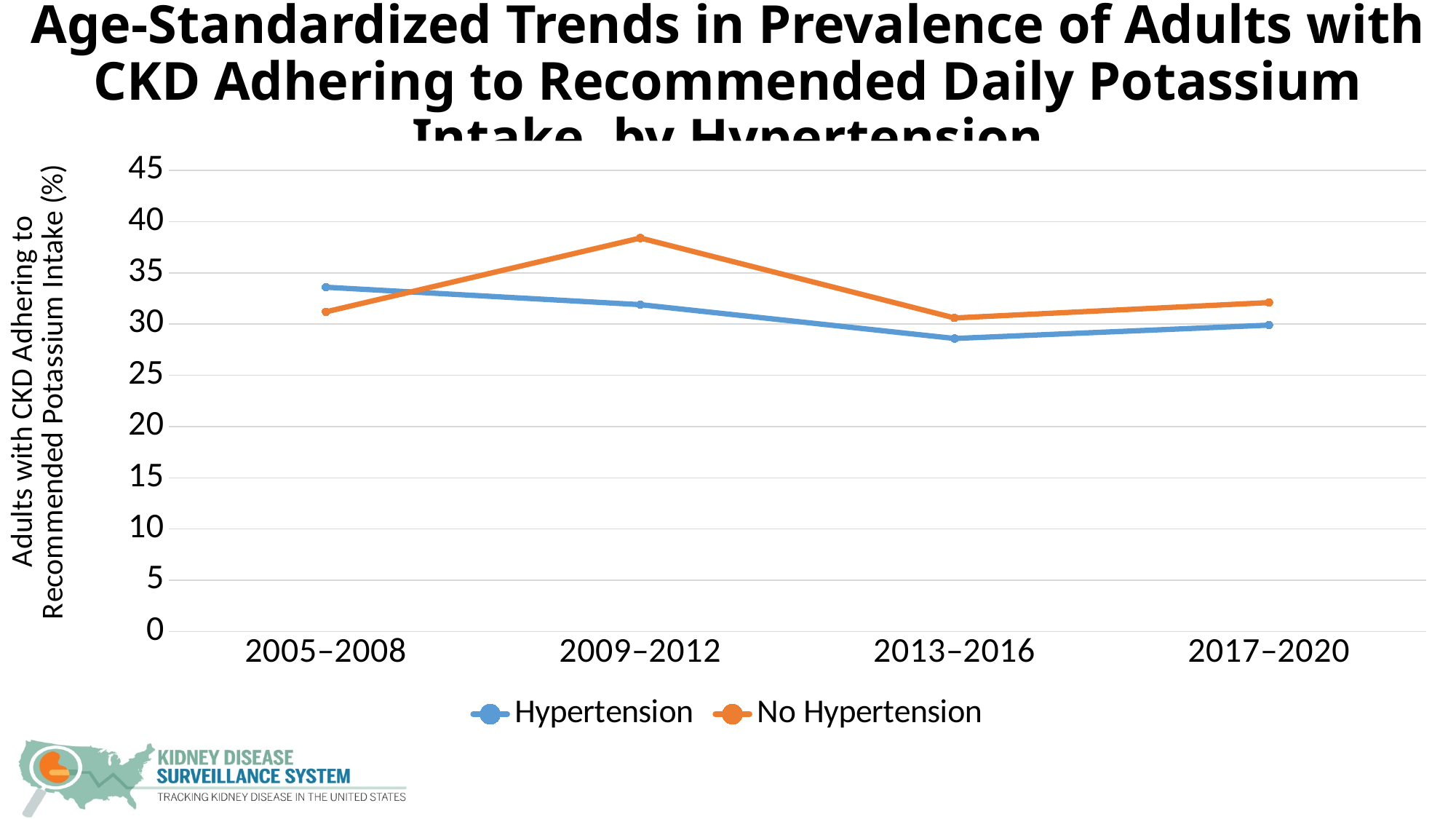
In which period is the No Hypertension series highest? 2009–2012 Is the value for Hypertension in 2005–2008 greater or less than 30? greater Is the value for Hypertension in 2013–2016 greater or less than 30? less Does the Hypertension series rise or fall from 2005–2008 to 2013–2016? fall How many series does the legend list? 2 How many time periods are shown on the x axis? 4 In which period is the Hypertension series lowest? 2013–2016 In 2005–2008, which series has the higher value, Hypertension or No Hypertension? Hypertension What colour is the line for the No Hypertension series? Orange In 2017–2020, which series has the higher value, Hypertension or No Hypertension? No Hypertension What kind of chart is shown on the slide? Line chart Is the value for No Hypertension in 2009–2012 greater or less than 35? greater